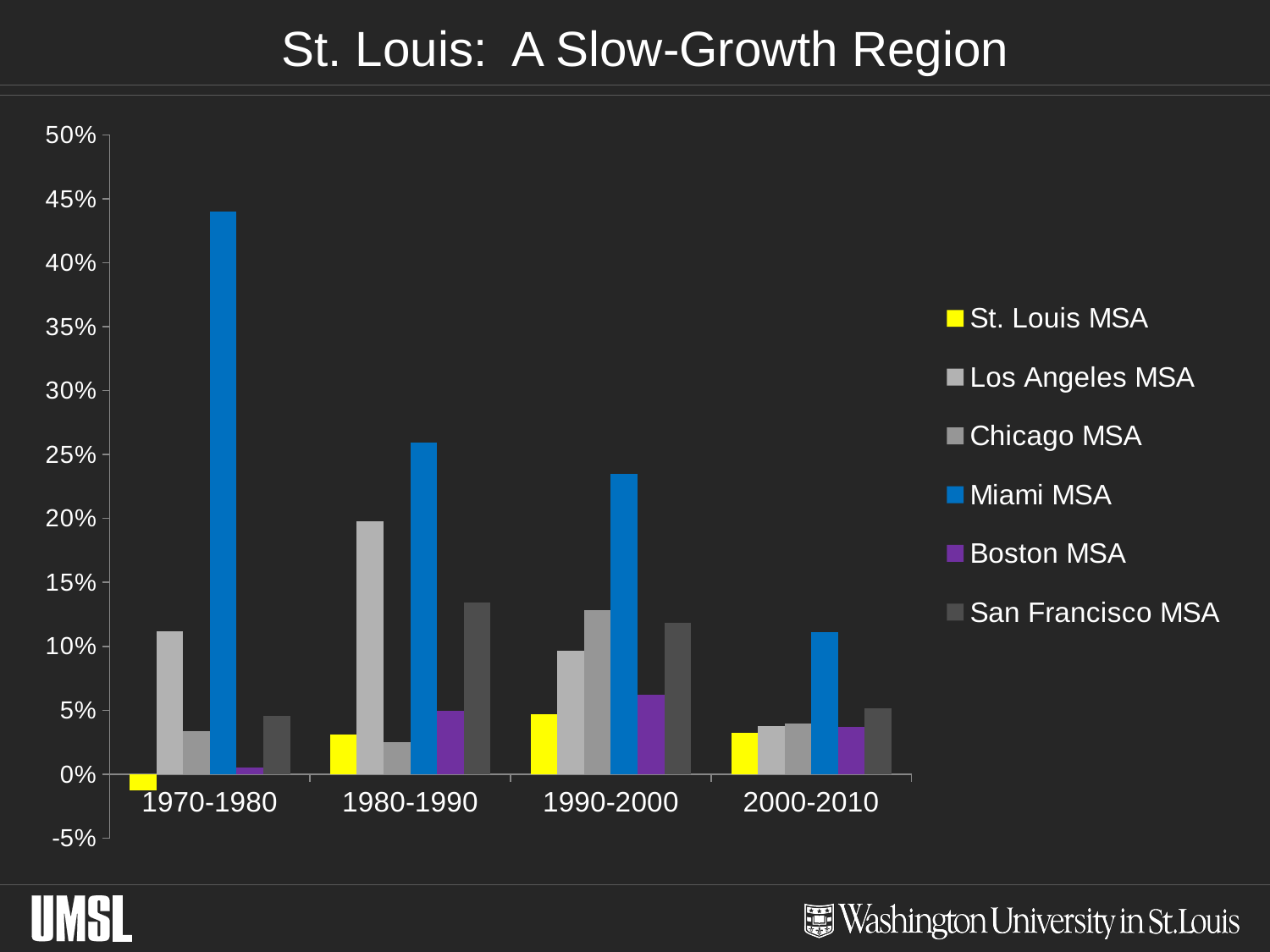
Do the values for Miami MSA rise or fall from 1970-1980 to 2000-2010? fall Which MSA has the lowest value in the 1970-1980 period? St. Louis MSA What kind of chart is shown on the slide? bar chart In the 1980-1990 period, which is larger: San Francisco MSA or Boston MSA? San Francisco MSA Is the value for St. Louis MSA in 1970-1980 greater or less than 0%? less Is the value for Miami MSA in 1970-1980 greater or less than 40%? greater Is the value for Los Angeles MSA in 1980-1990 greater or less than 15%? greater In the 1990-2000 period, which is larger: Chicago MSA or Los Angeles MSA? Chicago MSA How many time periods are shown on the x axis? 4 How many series does the legend list? 6 Which MSA has the highest value in the 1970-1980 period? Miami MSA What is the title of the slide? St. Louis: A Slow-Growth Region